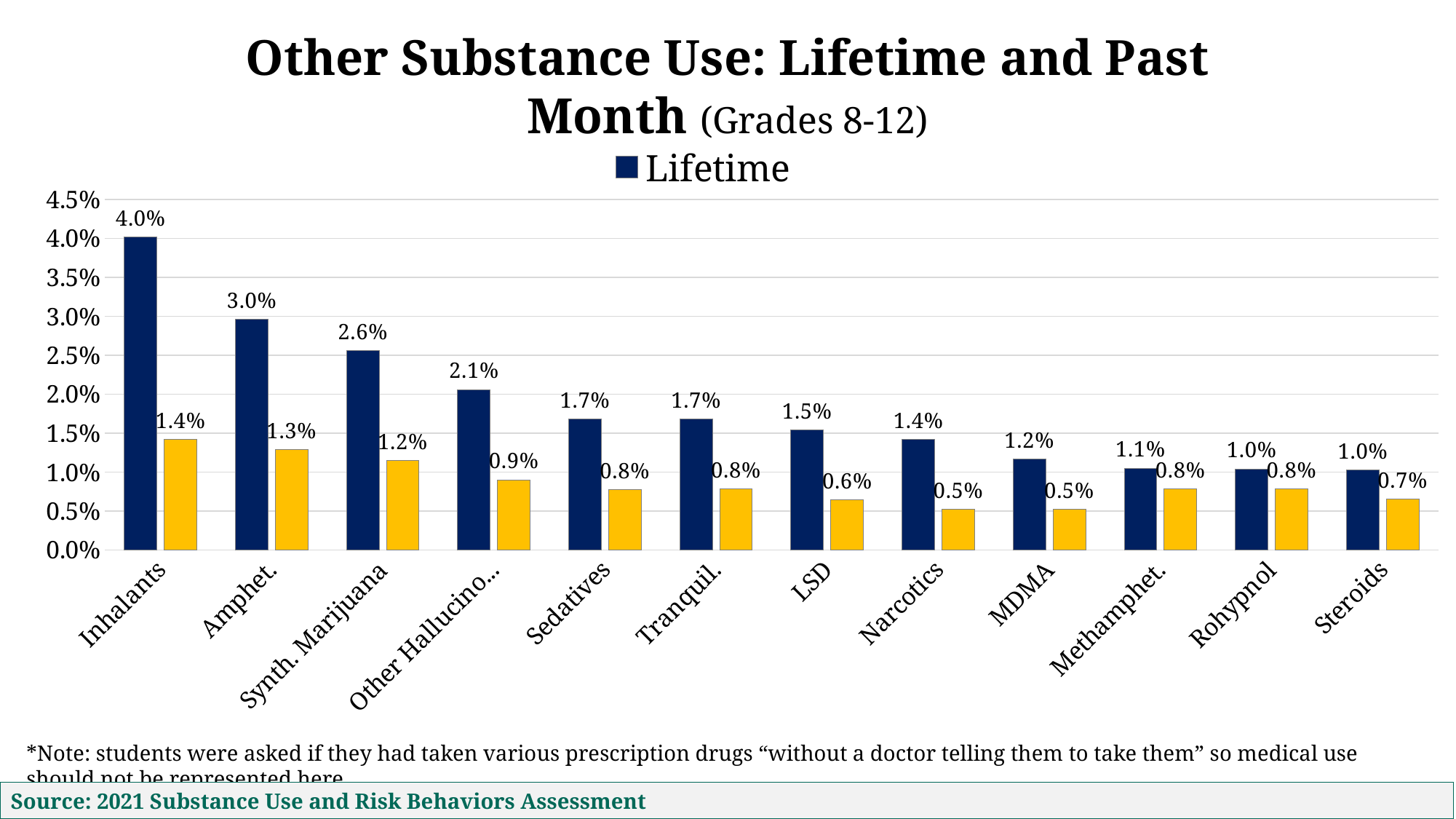
What kind of chart is shown on the slide? Bar chart Which category has the highest Lifetime value? Inhalants What is the value of the yellow bar for Synth. Marijuana? 1.2% What is the difference between the Lifetime value and the yellow bar value for Inhalants? 2.6% How many series does the legend list? 1 What is the Lifetime value for Inhalants? 4.0% Do the Lifetime values rise or fall from left to right across the categories? Fall What is the value of the yellow bar for Methamphet.? 0.8% What is the Lifetime value for LSD? 1.5% How many substance categories are shown on the x axis? 12 What is the difference between the Lifetime values for Inhalants and Amphet.? 1.0% Which has the larger Lifetime value, Amphet. or Synth. Marijuana? Amphet.